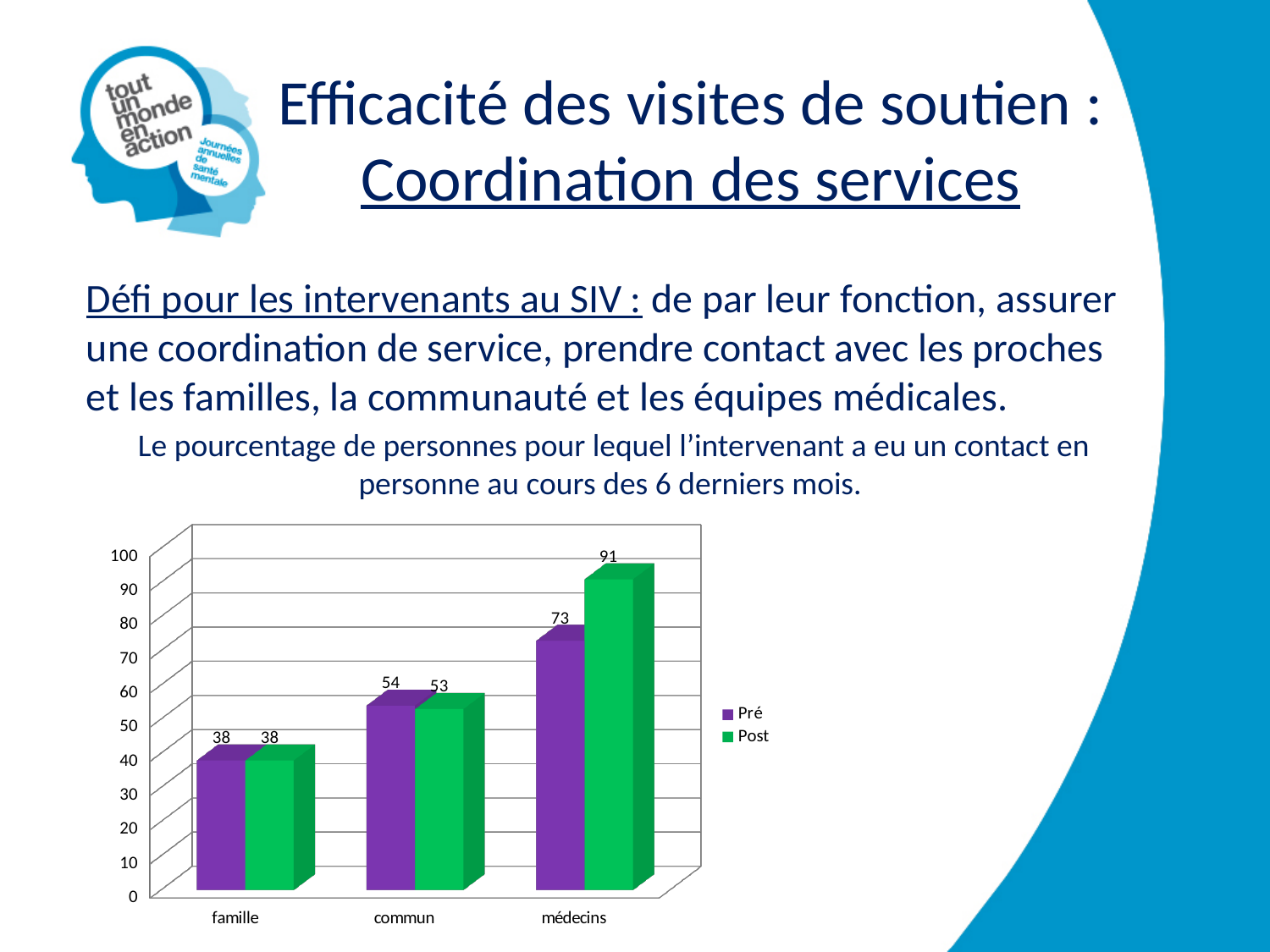
What is the Post value for commun? 53 What is the Post value for médecins? 91 Which category has the highest Post value? médecins Which is larger for commun, the Pré value or the Post value? Pré What is the difference between the Post and Pré values for médecins? 18 Which category has the lowest Pré value? famille How many series does the legend list? 2 What kind of chart is shown on the slide? bar chart What is the Pré value for médecins? 73 What is the Pré value for famille? 38 How many categories are shown on the x axis? 3 Do the Pré values rise or fall from famille to médecins? rise